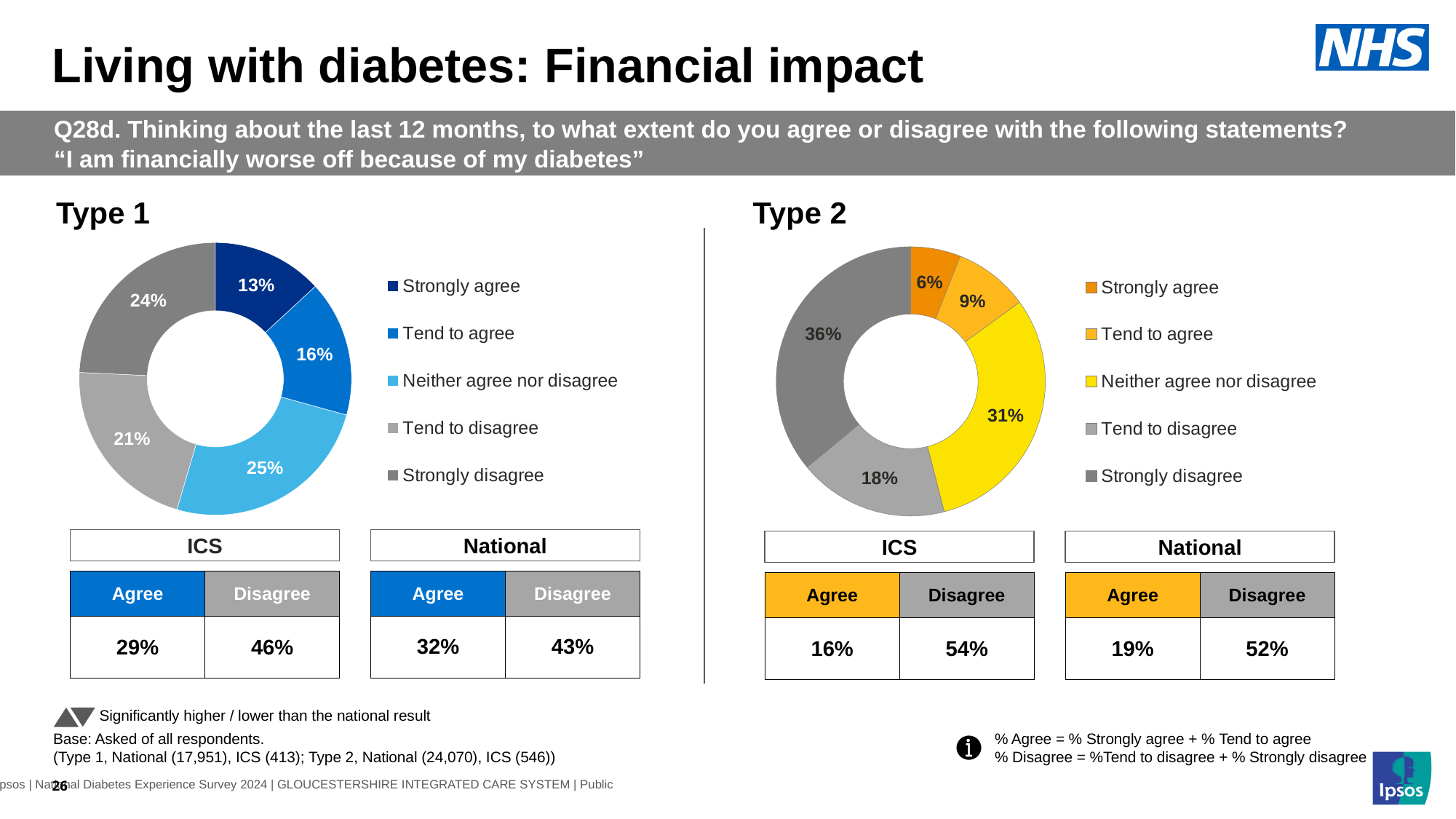
How many response categories does the legend of the Type 1 chart list? 5 In the Type 2 chart, which response category has the smallest share? Strongly agree In the Type 1 chart, what is the combined share of Strongly agree and Tend to agree? 29% In the Type 1 chart, what percentage of respondents strongly agree? 13% In the Type 1 chart, which response category has the largest share? Neither agree nor disagree In the Type 1 chart, what is the difference between the Tend to agree share and the Strongly agree share? 3% In the Type 2 chart, is the share for Strongly disagree larger or smaller than the share for Tend to disagree? larger In the Type 2 chart, what percentage of respondents neither agree nor disagree? 31% In the Type 2 chart, which response category has the largest share? Strongly disagree In the Type 2 chart, what colour is the Neither agree nor disagree segment? Yellow In the Type 1 chart, what is the difference between the Strongly disagree share and the Tend to disagree share? 3% What kind of chart is used to show the Type 2 results? Doughnut chart